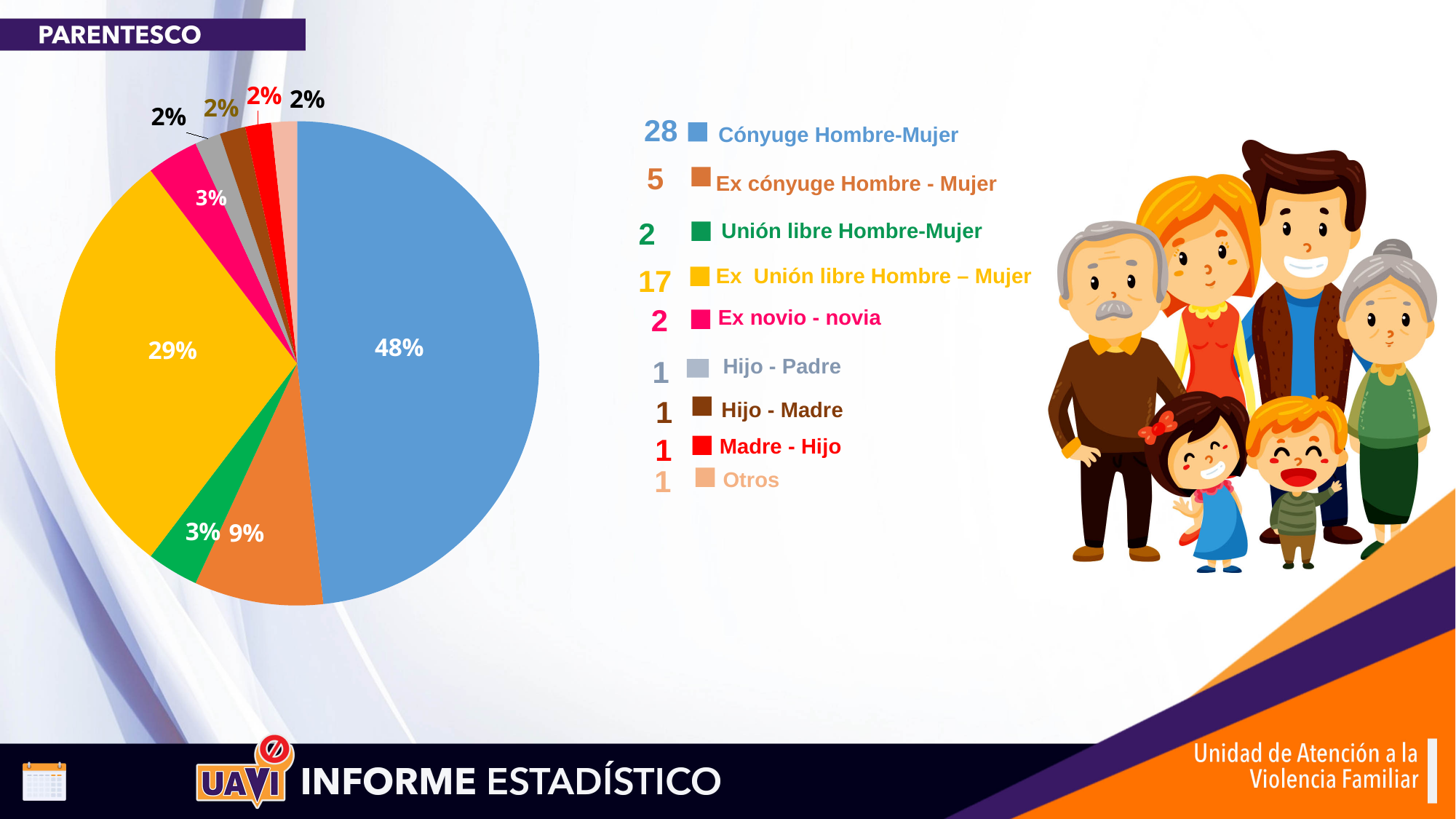
What share of the pie does Ex Unión libre Hombre – Mujer represent? 29% How many categories does the pie chart's legend list? 9 What share of the pie does Cónyuge Hombre-Mujer represent? 48% What count is shown in the legend for Ex novio - novia? 2 What share of the pie does Ex cónyuge Hombre - Mujer represent? 9% What is the title of the chart on the slide? PARENTESCO What count is shown in the legend for Ex Unión libre Hombre – Mujer? 17 What is the difference between the counts for Cónyuge Hombre-Mujer and Ex Unión libre Hombre – Mujer? 11 Which is larger, the count for Ex cónyuge Hombre - Mujer or the count for Unión libre Hombre-Mujer? Ex cónyuge Hombre - Mujer What count is shown in the legend for Cónyuge Hombre-Mujer? 28 What kind of chart is shown on the slide? pie chart Which category has the largest slice of the pie? Cónyuge Hombre-Mujer